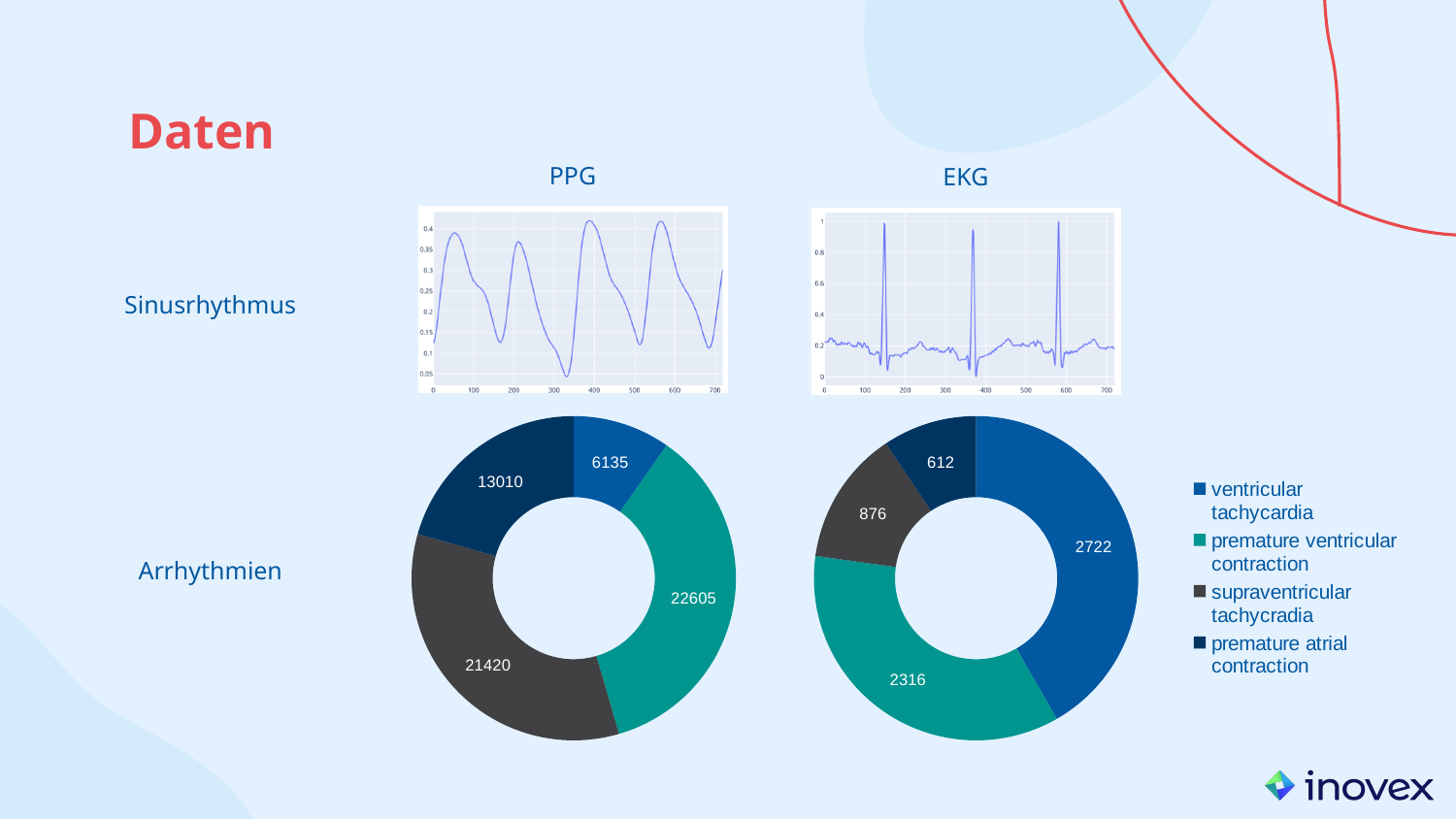
What kind of chart is used for the Arrhythmien data under PPG? Donut (pie) chart What kind of chart is used for the Sinusrhythmus PPG signal? Line chart In the EKG Arrhythmien donut chart, what is the value for supraventricular tachycardia? 876 In the PPG Arrhythmien donut chart, what is the value for premature atrial contraction? 13010 In the PPG Arrhythmien donut chart, what is the difference between premature ventricular contraction and supraventricular tachycardia? 1185 In the EKG Arrhythmien donut chart, which category has the largest value? ventricular tachycardia In the PPG Arrhythmien donut chart, what is the value for premature ventricular contraction? 22605 What is the total of all four values in the EKG Arrhythmien donut chart? 6526 In the EKG Arrhythmien donut chart, what is the difference between ventricular tachycardia and premature ventricular contraction? 406 In the EKG Arrhythmien donut chart, which is larger: supraventricular tachycardia or premature atrial contraction? supraventricular tachycardia In the PPG Arrhythmien donut chart, which category has the smallest value? ventricular tachycardia How many categories does the legend for the Arrhythmien donut charts list? 4